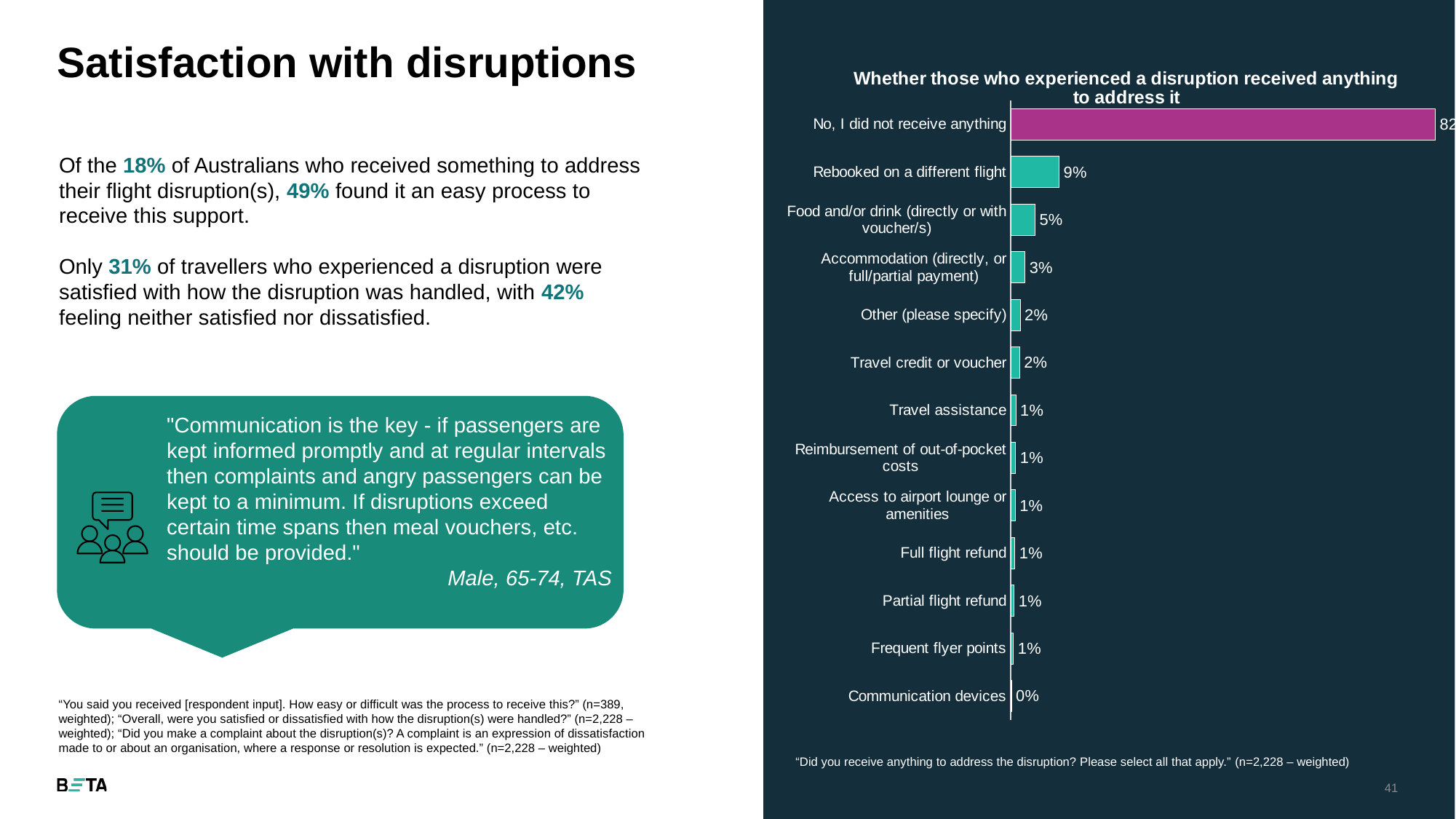
Which category has the highest value in the chart? No, I did not receive anything What is the value for 'Accommodation (directly, or full/partial payment)'? 3% Which is larger: the value for 'Rebooked on a different flight' or for 'Accommodation (directly, or full/partial payment)'? Rebooked on a different flight What is the value for 'Rebooked on a different flight'? 9% What kind of chart is shown on the slide? bar chart What is the value for 'Travel credit or voucher'? 2% What is the value for 'Communication devices'? 0% How many categories are plotted in the chart? 13 What is the difference between the values for 'Rebooked on a different flight' and 'Food and/or drink (directly or with voucher/s)'? 4% What is the title of the chart? Whether those who experienced a disruption received anything to address it What is the value for 'Food and/or drink (directly or with voucher/s)'? 5% Which category has the lowest value in the chart? Communication devices